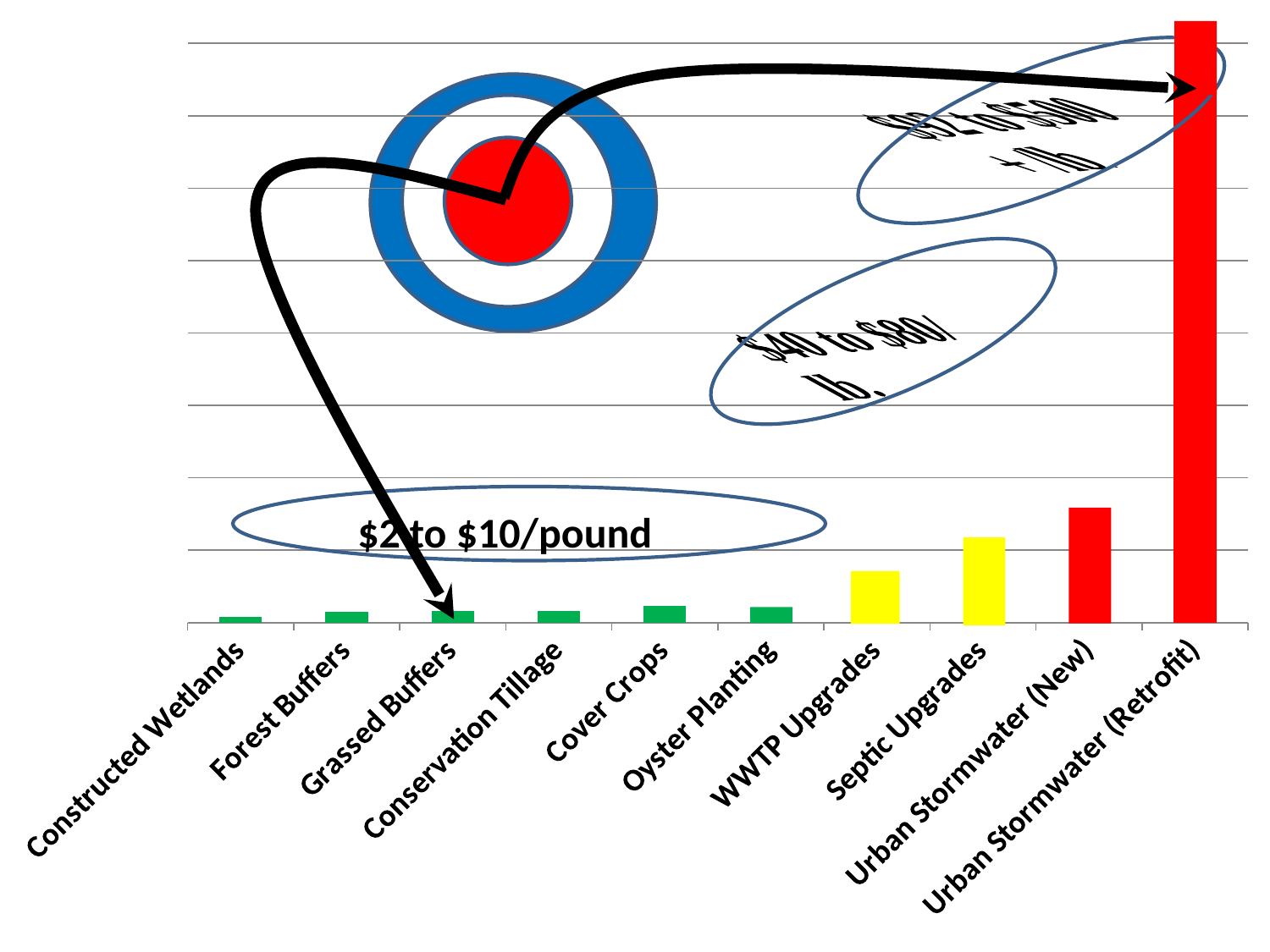
Which category has the lowest bar? Constructed Wetlands Do the bar values generally rise or fall from left to right along the x axis? rise What kind of chart is shown on the slide? bar chart What cost range is written in the annotation near the Grassed Buffers bar? $2 to $10/pound Which is larger, the value for Septic Upgrades or WWTP Upgrades? Septic Upgrades What colour are the bars for Urban Stormwater (New) and Urban Stormwater (Retrofit)? red Which category has the highest bar? Urban Stormwater (Retrofit) Which is larger, the value for Urban Stormwater (New) or Septic Upgrades? Urban Stormwater (New) Which is larger, the value for WWTP Upgrades or Oyster Planting? WWTP Upgrades How many categories are plotted on the x axis? 10